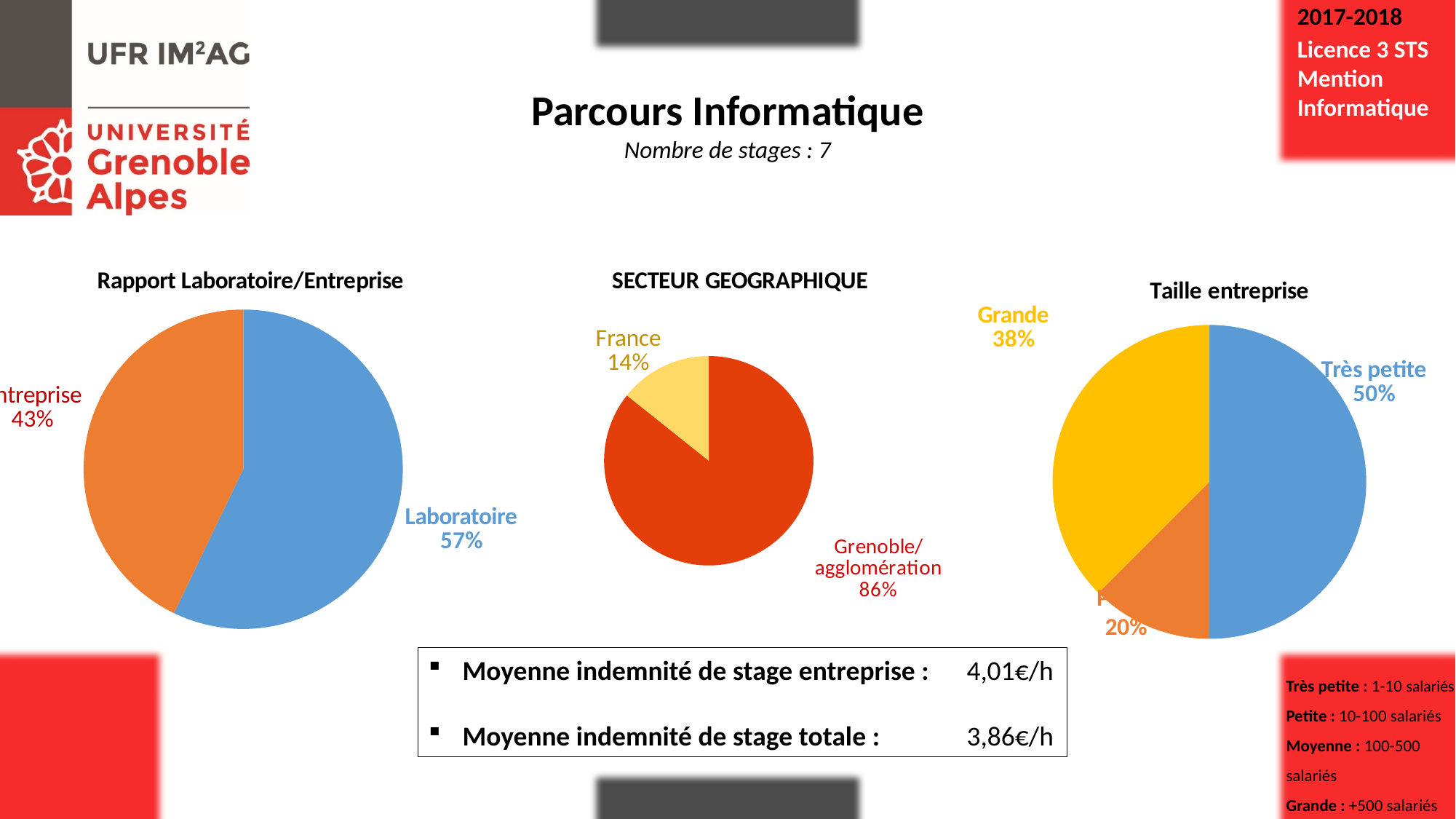
In the "Taille entreprise" chart, what share does Grande have? 38% In the "SECTEUR GEOGRAPHIQUE" chart, which slice is the largest? Grenoble/agglomération In the "SECTEUR GEOGRAPHIQUE" chart, what share does France have? 14% In the "Taille entreprise" chart, what share does Très petite have? 50% How many slices does the "SECTEUR GEOGRAPHIQUE" pie chart have? 2 How many slices does the "Taille entreprise" pie chart have? 3 What kind of chart is the "Rapport Laboratoire/Entreprise" chart? Pie chart In the "Rapport Laboratoire/Entreprise" chart, which slice is larger, Laboratoire or Entreprise? Laboratoire In the "Rapport Laboratoire/Entreprise" chart, what is the difference between the Laboratoire and Entreprise shares? 14%